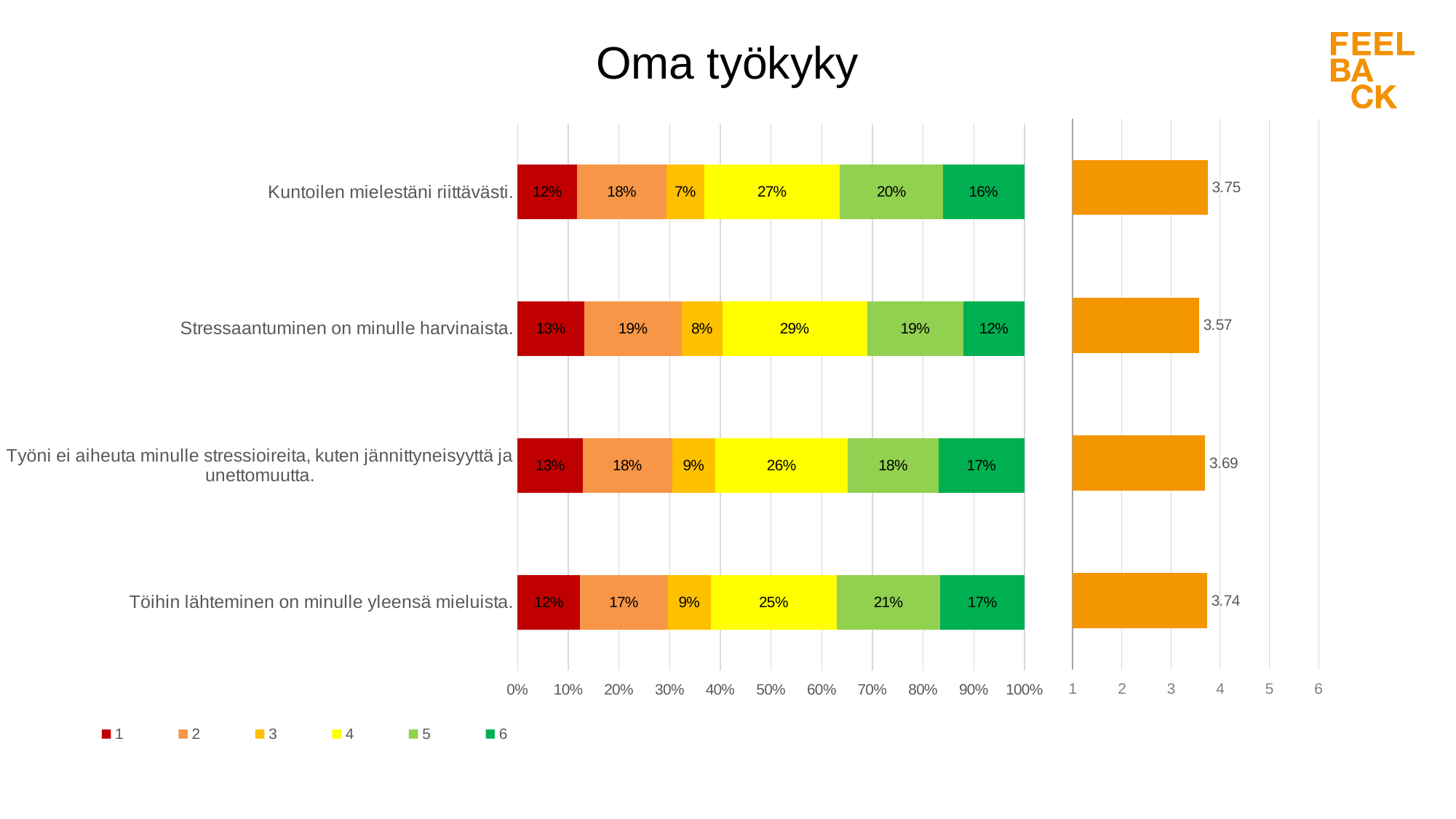
On the right-hand bar chart, which category has the lowest value? Stressaantuminen on minulle harvinaista. On the right-hand bar chart, what is the value for "Stressaantuminen on minulle harvinaista."? 3.57 On the left-hand stacked bar chart, what is the difference between the series 2 and series 3 values for "Stressaantuminen on minulle harvinaista."? 11% How many categories are shown on the left-hand stacked bar chart? 4 On the left-hand stacked bar chart, what is the value of series 4 for "Stressaantuminen on minulle harvinaista."? 29% On the left-hand stacked bar chart, what is the value of series 3 for "Työni ei aiheuta minulle stressioireita, kuten jännittyneisyyttä ja unettomuutta."? 9% On the left-hand stacked bar chart, is the series 4 value larger for "Stressaantuminen on minulle harvinaista." or for "Töihin lähteminen on minulle yleensä mieluista."? Stressaantuminen on minulle harvinaista. On the right-hand bar chart, what is the value for "Kuntoilen mielestäni riittävästi."? 3.75 What kind of chart is the right-hand chart on the slide? Bar chart On the right-hand bar chart, what is the difference between the values for "Kuntoilen mielestäni riittävästi." and "Stressaantuminen on minulle harvinaista."? 0.18 How many series does the legend of the left-hand stacked bar chart list? 6 On the left-hand stacked bar chart, what is the value of series 6 for "Kuntoilen mielestäni riittävästi."? 16%